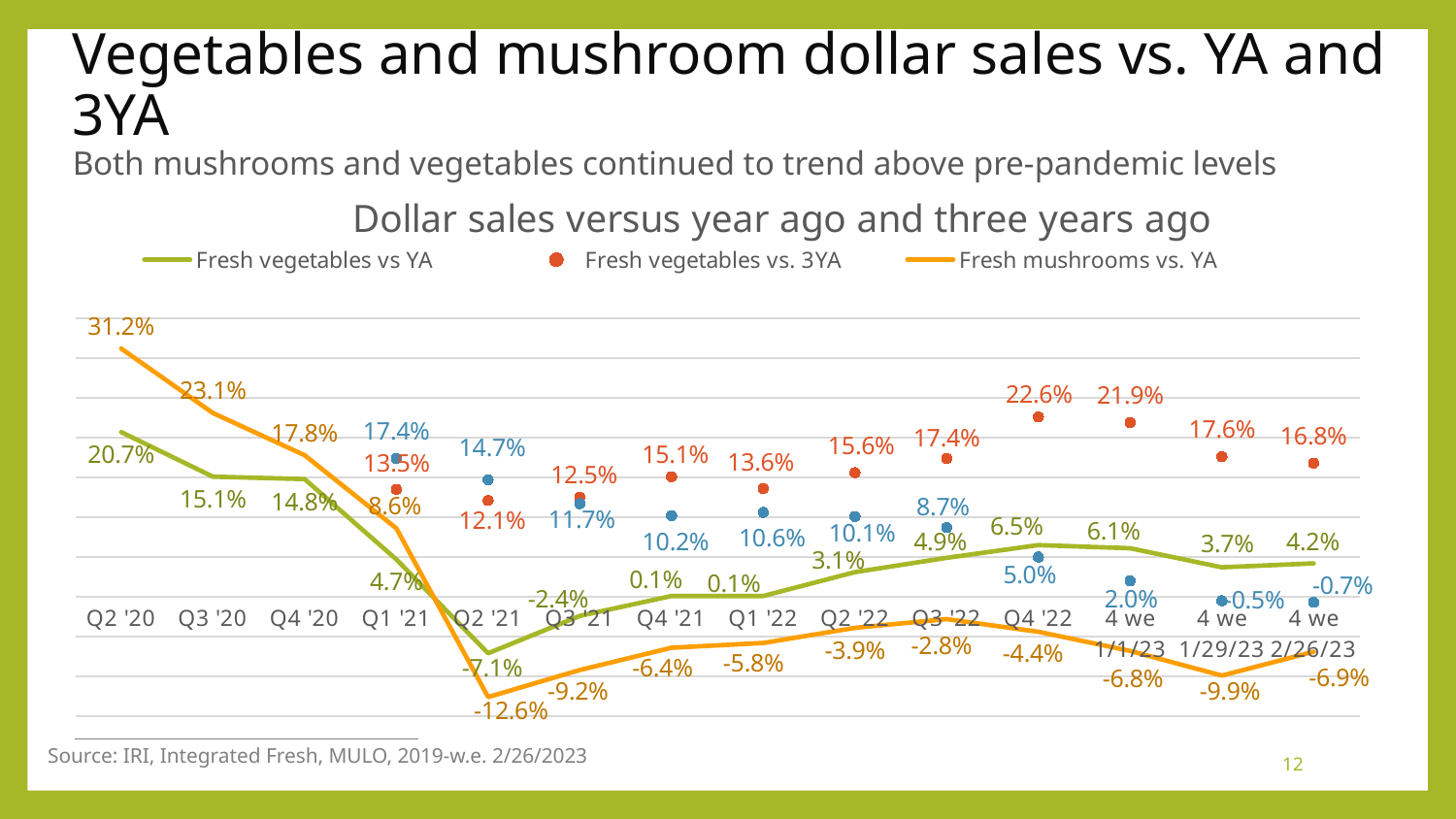
What is the value for Fresh vegetables vs. 3YA in Q4 '22? 22.6% What is the value for Fresh vegetables vs YA in Q2 '21? -7.1% What kind of chart is shown on the slide? Line chart In which period is Fresh vegetables vs. 3YA at its highest? Q4 '22 In which period is Fresh mushrooms vs. YA at its lowest? Q2 '21 What is the difference between Fresh mushrooms vs. YA in Q2 '20 and Q3 '20? 8.1 percentage points What is the title of the chart? Dollar sales versus year ago and three years ago In Q1 '21, which is larger: Fresh vegetables vs YA or Fresh mushrooms vs. YA? Fresh mushrooms vs. YA What is the value for Fresh mushrooms vs. YA in Q2 '20? 31.2% Does Fresh mushrooms vs. YA rise or fall from Q2 '20 to Q2 '21? Fall How many series does the legend list? 3 What is the value for Fresh vegetables vs YA in Q4 '22? 6.5%